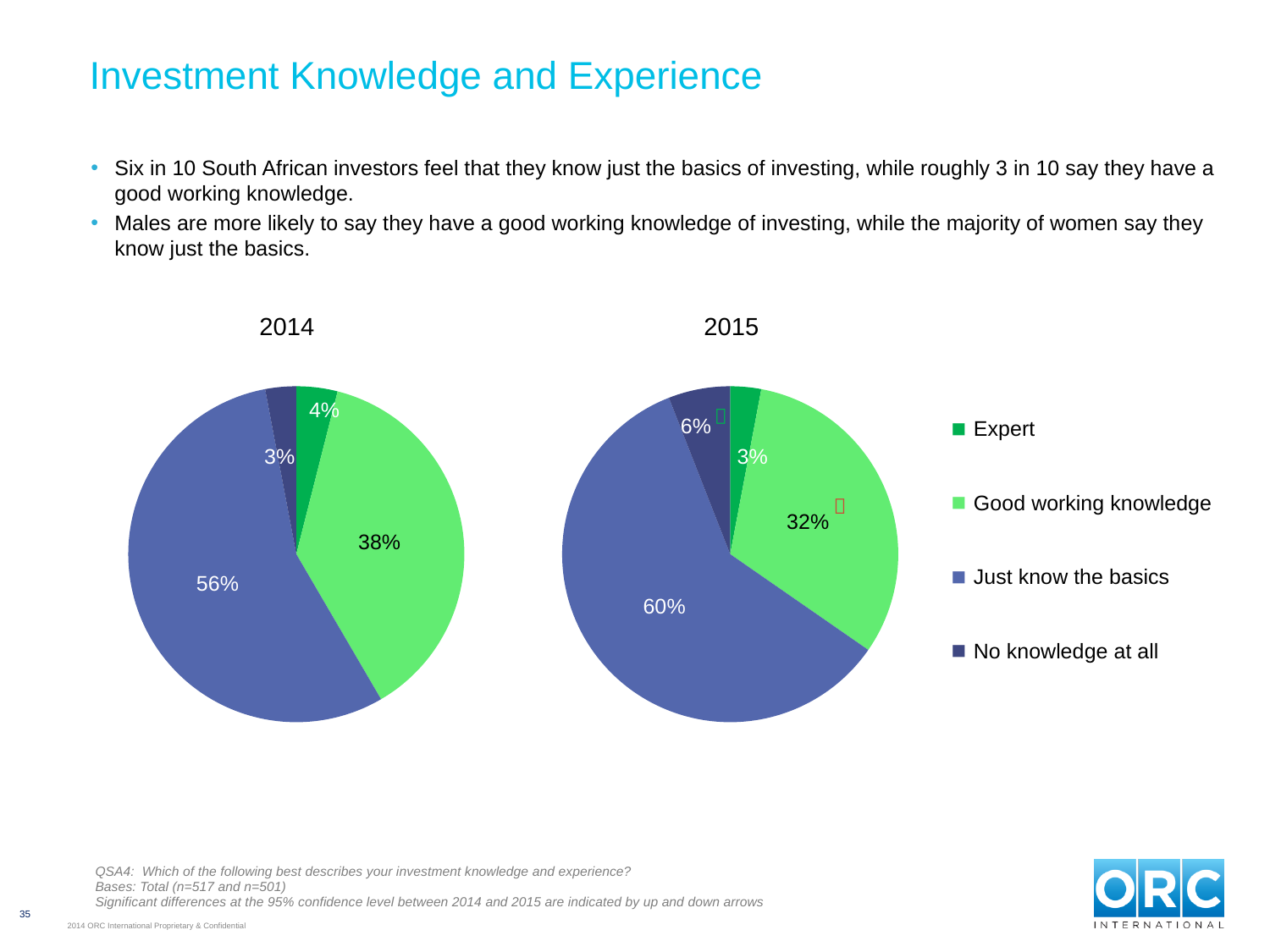
What is the difference between the 'Just know the basics' share in 2015 and in 2014? 4 percentage points In the 2015 pie chart, what share of investors say they have no knowledge at all? 6% In the 2015 pie chart, what is the combined share of 'Expert' and 'Good working knowledge'? 35% In the 2015 pie chart, what share of investors say they have a good working knowledge? 32% In the 2014 pie chart, what share of investors describe themselves as Expert? 4% In the 2014 pie chart, which category has the smallest share? No knowledge at all How many categories does the legend list for the pie charts? 4 In the 2014 pie chart, what share of investors say they just know the basics? 56% Which is larger: the 'Good working knowledge' share in 2014 or in 2015? 2014 In the 2015 pie chart, which category has the largest share? Just know the basics Which colour represents 'Just know the basics' in the legend? Blue What type of chart is used to show the 2014 and 2015 data? Pie chart